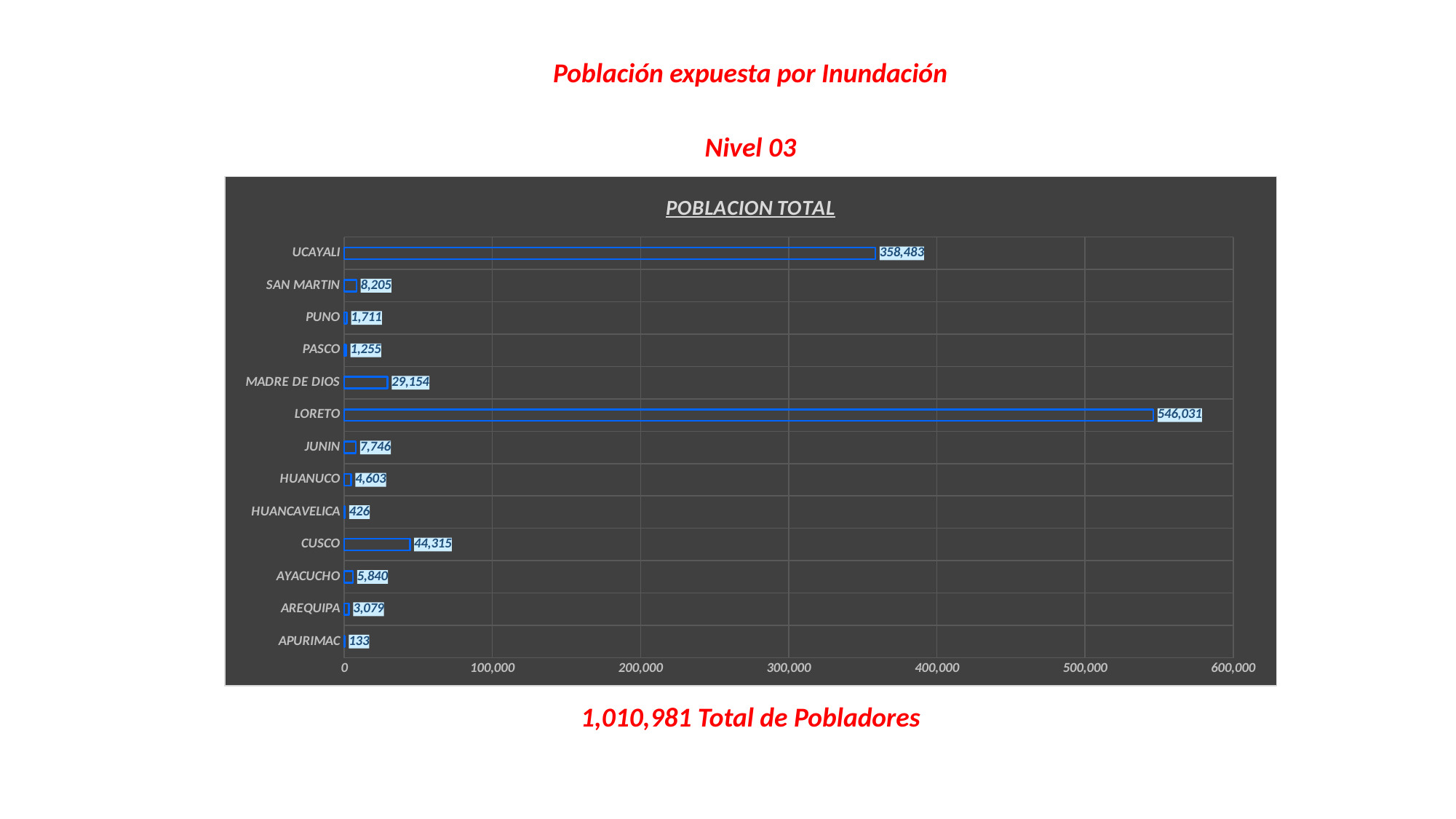
How many categories are shown in the chart? 13 What is the value for LORETO? 546,031 What is the difference between the values for LORETO and UCAYALI? 187,548 Which is larger, the value for CUSCO or the value for MADRE DE DIOS? CUSCO What is the difference between the values for SAN MARTIN and JUNIN? 459 Is the value for UCAYALI greater or less than 300,000? greater What is the value for HUANCAVELICA? 426 Which category has the highest value? LORETO What is the value for MADRE DE DIOS? 29,154 What is the title of the chart? POBLACION TOTAL What kind of chart is shown on the slide? bar chart Which category has the lowest value? APURIMAC